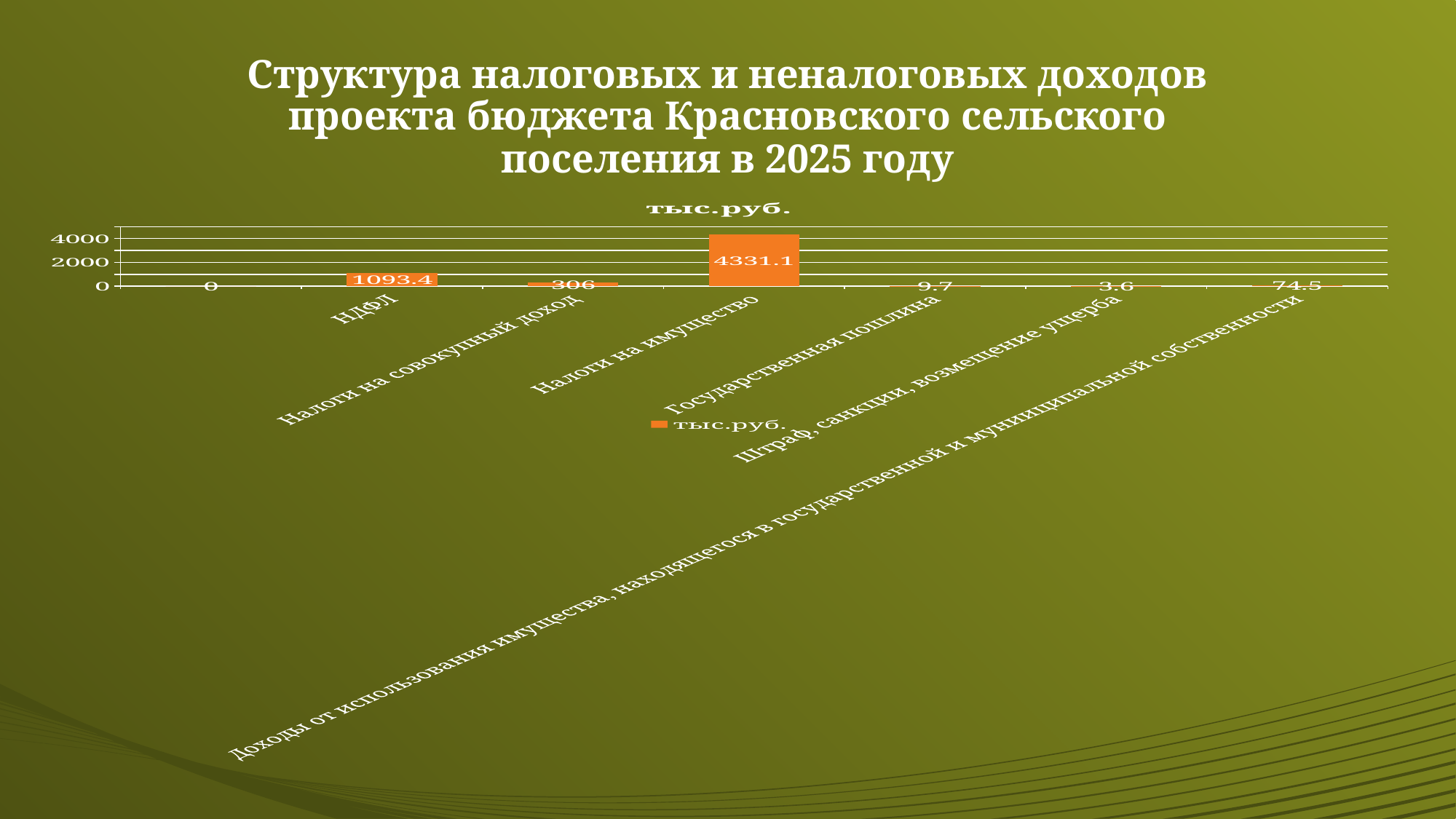
What is the value for Налоги на совокупный доход? 306 What is the value for Доходы от использования имущества, находящегося в государственной и муниципальной собственности? 74.5 Which category has the highest value? Налоги на имущество What is the difference between the values for Налоги на имущество and НДФЛ? 3237.7 Which is larger, the value for НДФЛ or the value for Налоги на совокупный доход? НДФЛ Is the value for Налоги на имущество greater or less than 4000? greater What is the value for НДФЛ? 1093.4 What is the value for Государственная пошлина? 9.7 What kind of chart is shown on the slide? bar chart Among the named categories, which has the lowest value? Штраф, санкции, возмещение ущерба What is the value for Штраф, санкции, возмещение ущерба? 3.6 What is the value for Налоги на имущество? 4331.1